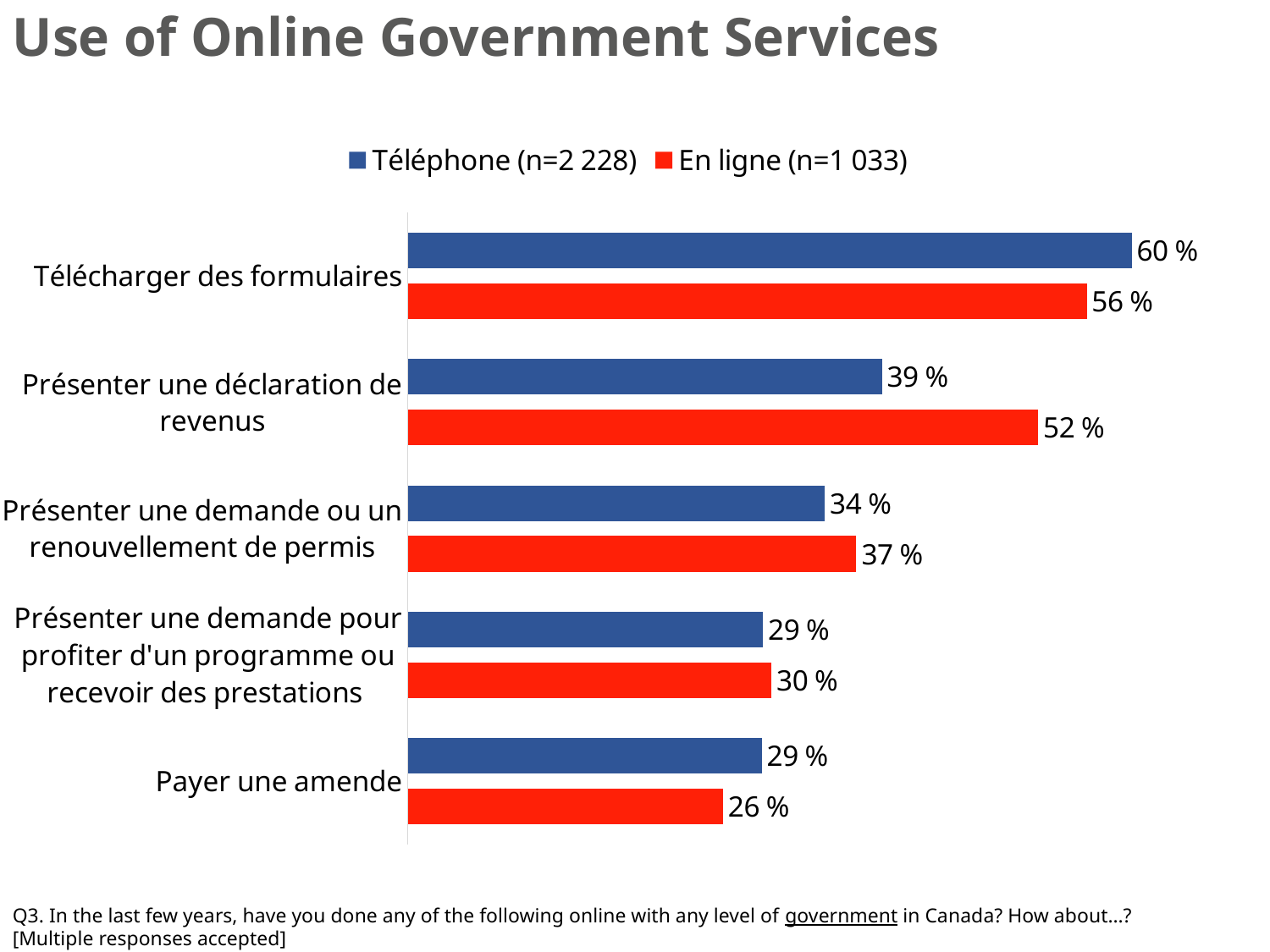
What is the En ligne value for Présenter une déclaration de revenus? 52 % Which category has the highest Téléphone value? Télécharger des formulaires For Présenter une demande ou un renouvellement de permis, which is larger: the Téléphone value or the En ligne value? En ligne Which category has the lowest En ligne value? Payer une amende For Payer une amende, which is larger: the Téléphone value or the En ligne value? Téléphone What is the Téléphone value for Télécharger des formulaires? 60 % What is the sample size (n) shown in the legend for the En ligne series? 1 033 How many series does the legend list? 2 What kind of chart is shown on the slide? Bar chart How many categories are shown on the chart? 5 What is the En ligne value for Payer une amende? 26 % What is the difference between the En ligne and Téléphone values for Présenter une déclaration de revenus? 13 %